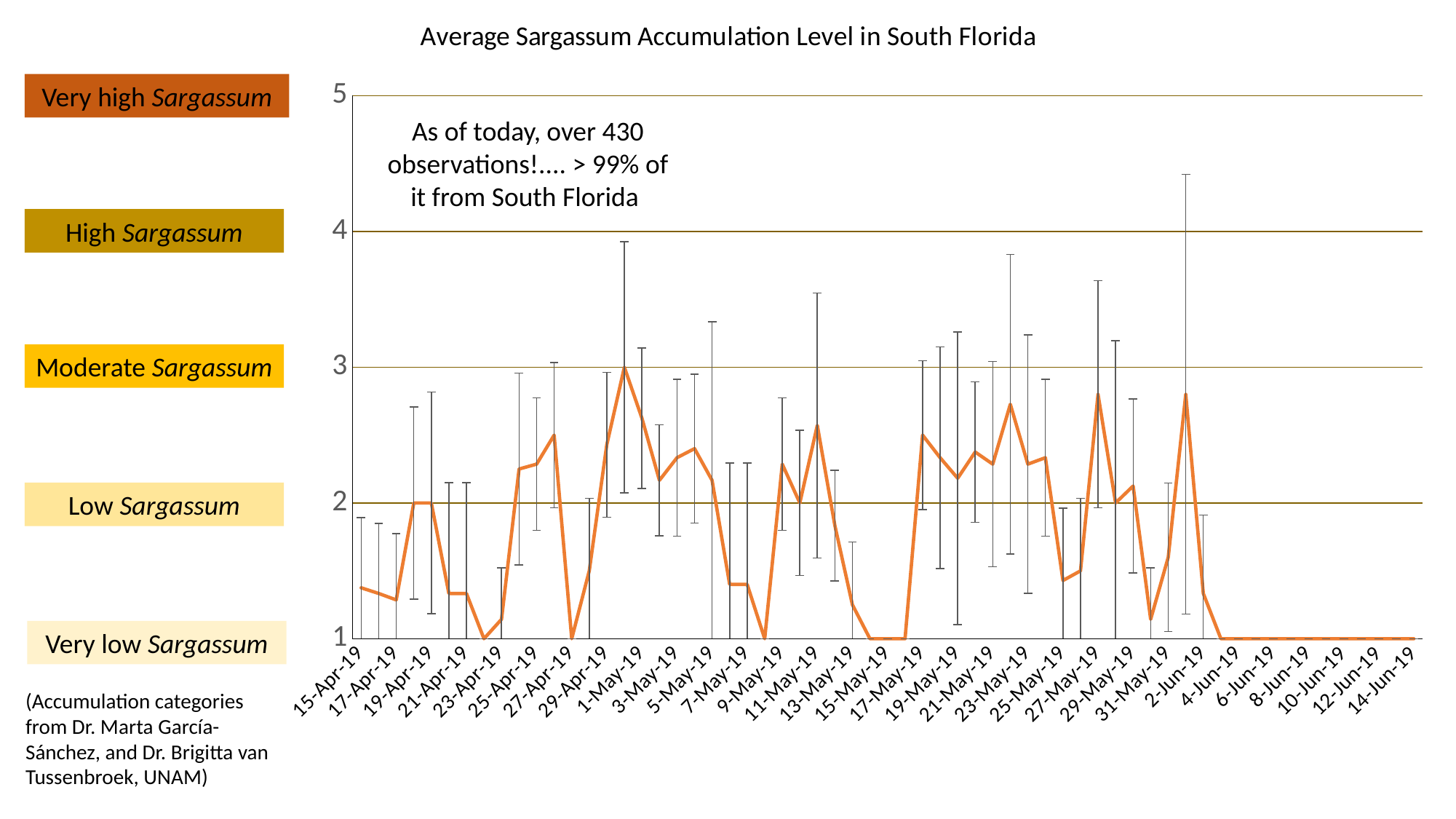
What is the average Sargassum accumulation level on 19-Apr-19? 2 What is the average Sargassum accumulation level on 14-Jun-19? 1 What is the highest value shown on the y axis? 5 Is the value for 27-Apr-19 greater or less than 2? less Between 2-Jun-19 and 4-Jun-19, does the average Sargassum accumulation level rise or fall? fall Is the value for 15-Apr-19 greater or less than 2? less Is the value for 6-Jun-19 greater or less than 2? less What kind of chart is shown on the slide? line chart Which date has the larger value, 1-May-19 or 13-May-19? 1-May-19 What is the title of the chart? Average Sargassum Accumulation Level in South Florida